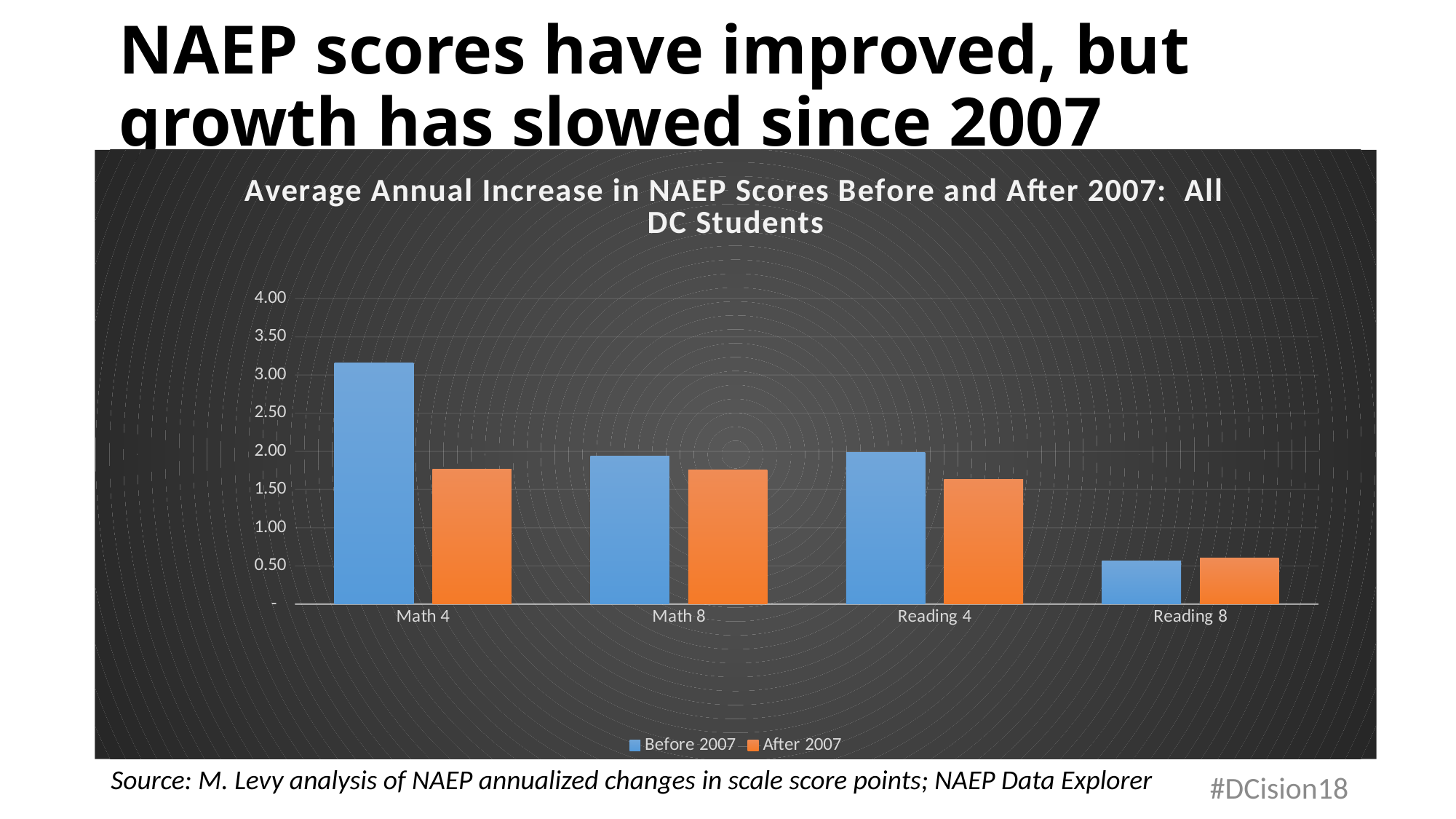
Which category has the highest Before 2007 value? Math 4 What is the title of the chart? Average Annual Increase in NAEP Scores Before and After 2007: All DC Students Is the After 2007 value for Reading 4 greater or less than 1.50? greater Is the After 2007 value for Math 4 greater or less than 2.00? less Which category has the lowest Before 2007 value? Reading 8 How many categories are shown on the x axis of the chart? 4 How many series does the chart's legend list? 2 Which category has the lowest After 2007 value? Reading 8 Is the Before 2007 value for Math 4 greater or less than 3.00? greater What kind of chart is shown on the slide? bar chart For Reading 4, which is larger: the Before 2007 value or the After 2007 value? Before 2007 For Math 4, which is larger: the Before 2007 value or the After 2007 value? Before 2007